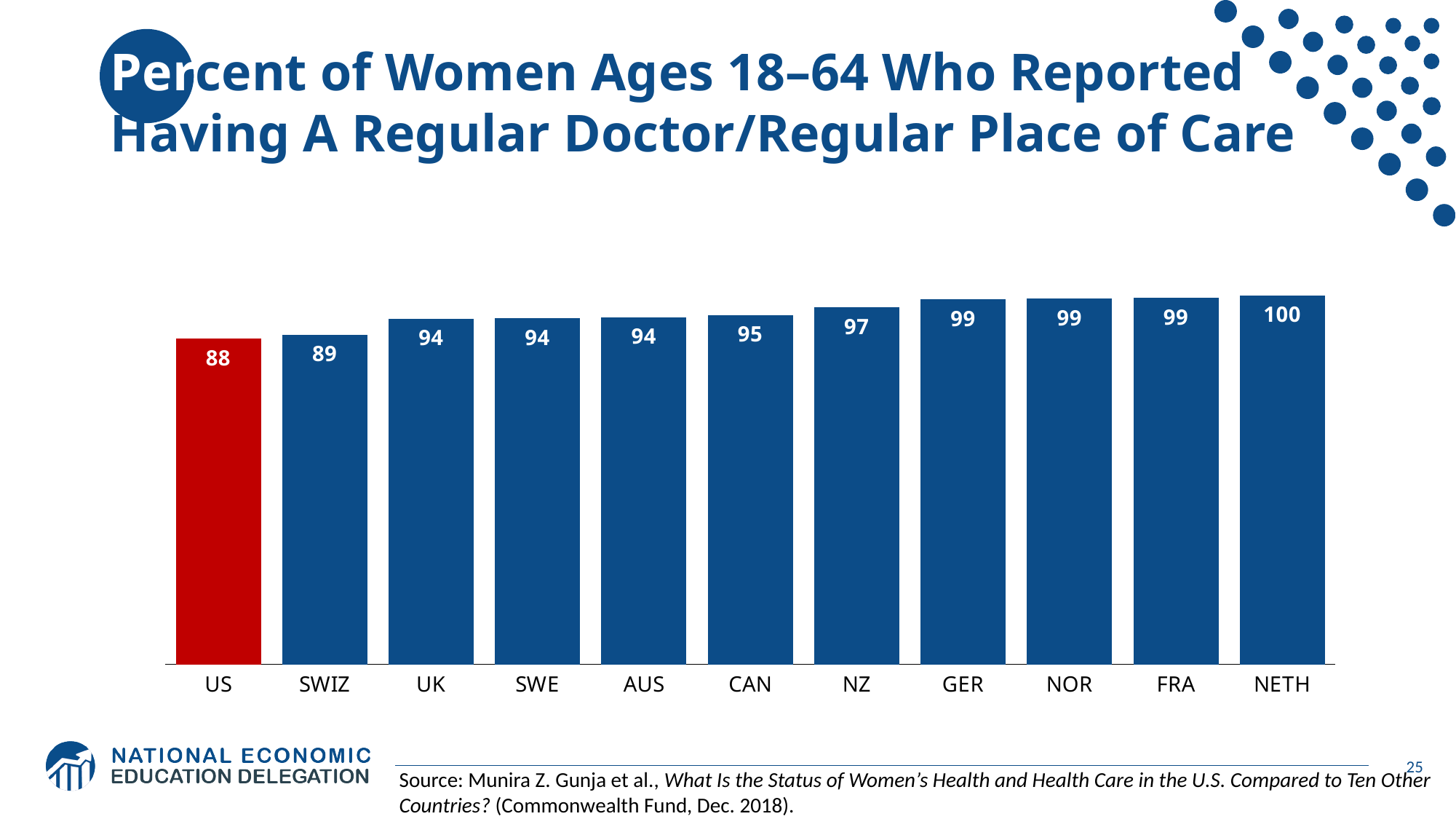
Which country has the lowest value? US Which is larger, the value for UK or the value for NZ? NZ What is the value for CAN? 95 What is the difference between the values for NETH and the US? 12 Which country has the highest value? NETH What is the value for the US? 88 What is the difference between the values for SWIZ and the US? 1 Do the values rise or fall from left to right along the x axis? rise What kind of chart is shown on the slide? bar chart What is the value for NZ? 97 Which bar is coloured red rather than blue? US How many countries are shown in the chart? 11